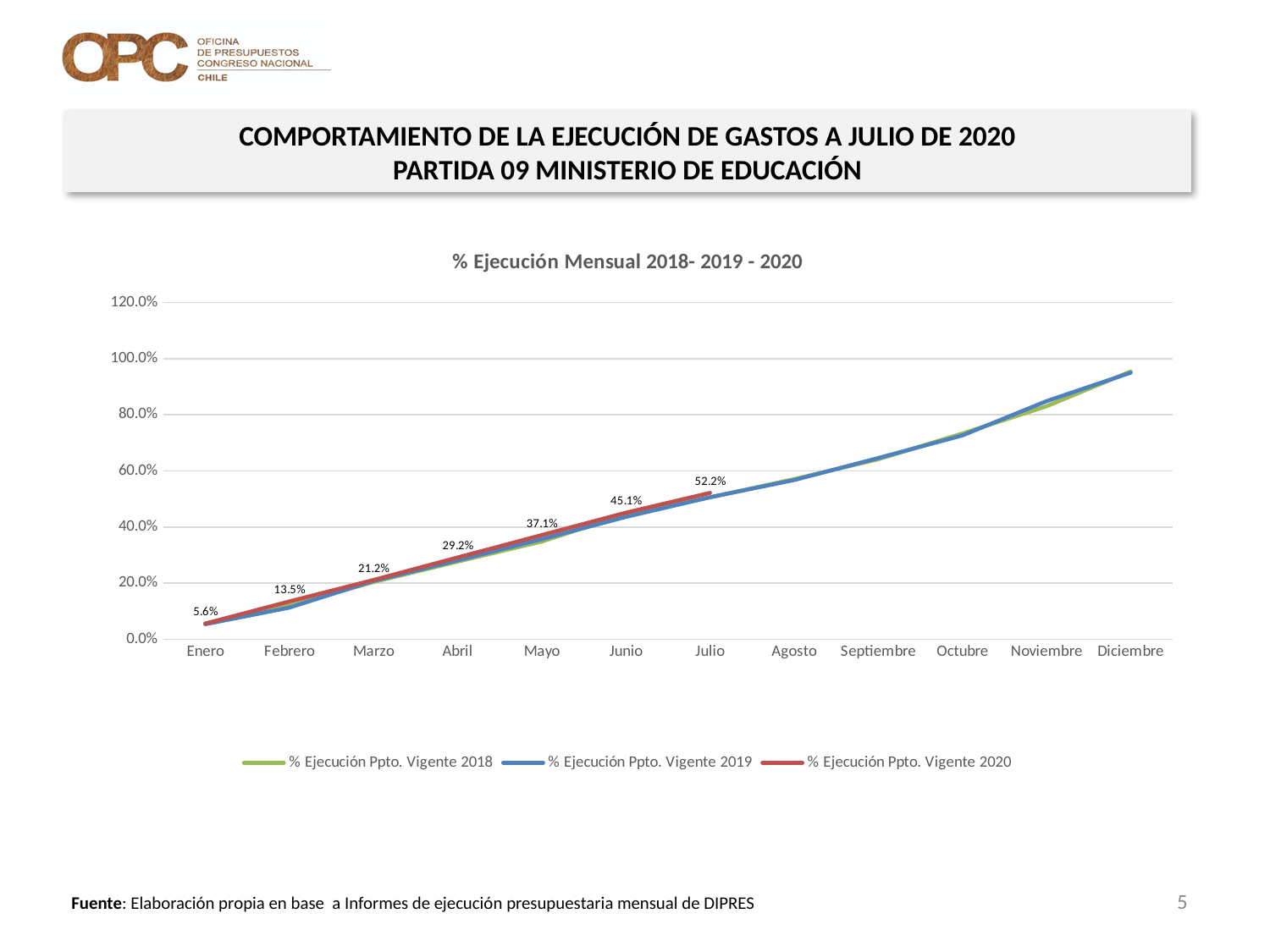
What is the value of % Ejecución Ppto. Vigente 2020 for Enero? 5.6% What kind of chart is shown on the slide? Line chart What is the value of % Ejecución Ppto. Vigente 2020 for Julio? 52.2% What is the difference between the 2020 values for Junio and Mayo? 8.0% What is the value of % Ejecución Ppto. Vigente 2020 for Mayo? 37.1% How many series does the legend list? 3 Is the value for % Ejecución Ppto. Vigente 2019 in Diciembre greater or less than 80.0%? greater What is the difference between the 2020 values for Julio and Enero? 46.6% Which month has the highest labelled value for % Ejecución Ppto. Vigente 2020? Julio Which month has the lowest labelled value for % Ejecución Ppto. Vigente 2020? Enero What is the value of % Ejecución Ppto. Vigente 2020 for Abril? 29.2% How many months are shown on the x axis? 12